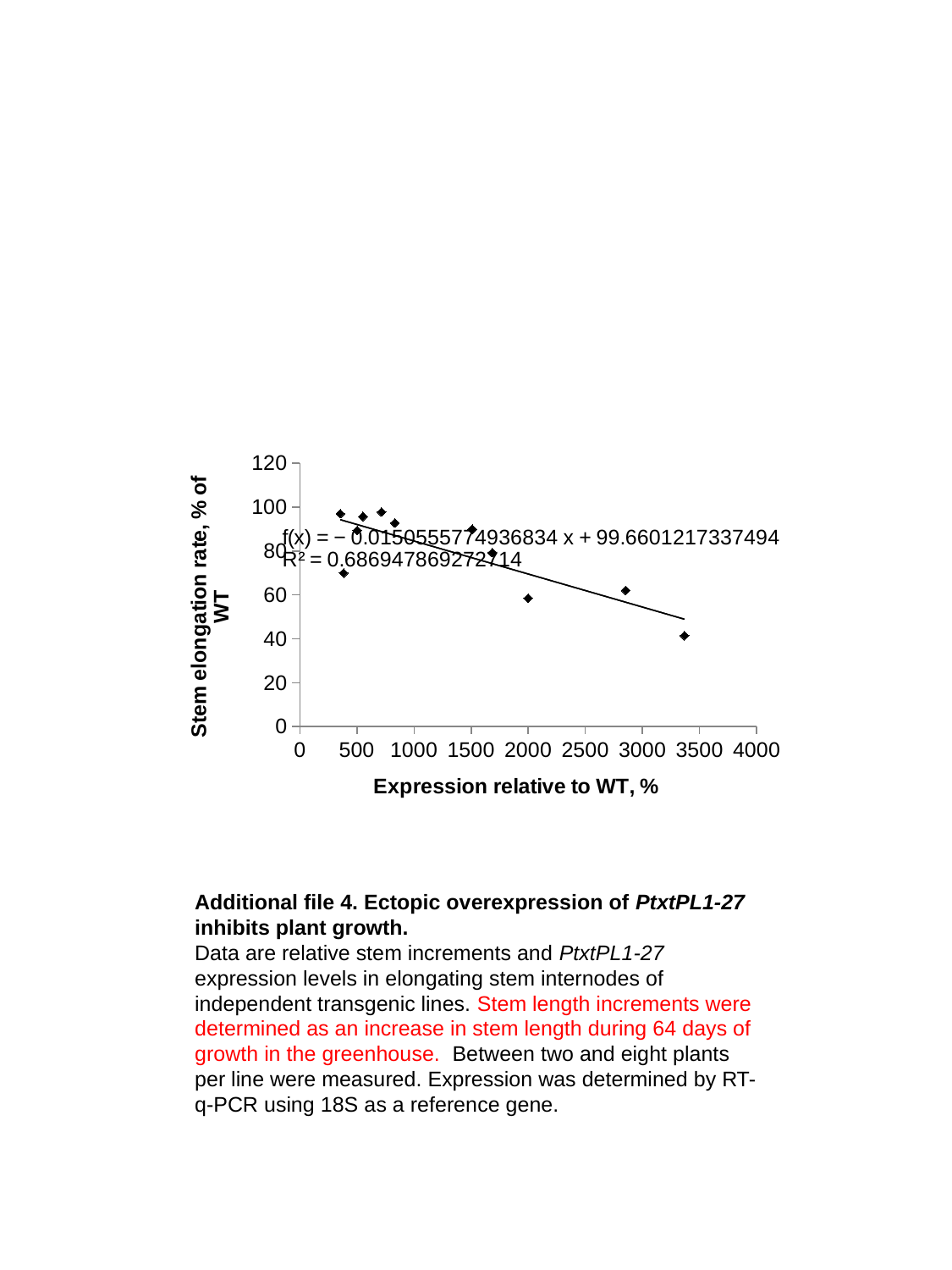
What is the intercept of the fitted line f(x) shown on the chart? 99.6601217337494 What kind of chart is shown on the slide? scatter plot What is the maximum value shown on the y axis? 120 What R² value is printed on the chart for the trendline? 0.686947869272714 Is the stem elongation rate of the data point near 2000% expression greater or less than 80? less What is the title of the x axis of the chart? Expression relative to WT, % What is the slope of the fitted line f(x) shown on the chart? −0.0150555774936834 Which has the higher stem elongation rate: the point near 2850% expression or the point near 3350% expression? the point near 2850% expression As expression relative to WT increases along the x axis, does the stem elongation rate generally rise or fall? fall Is the expression value of the rightmost data point greater or less than 3000? greater What is the title of the y axis of the chart? Stem elongation rate, % of WT Is the stem elongation rate of the point with the highest expression greater or less than 60? less